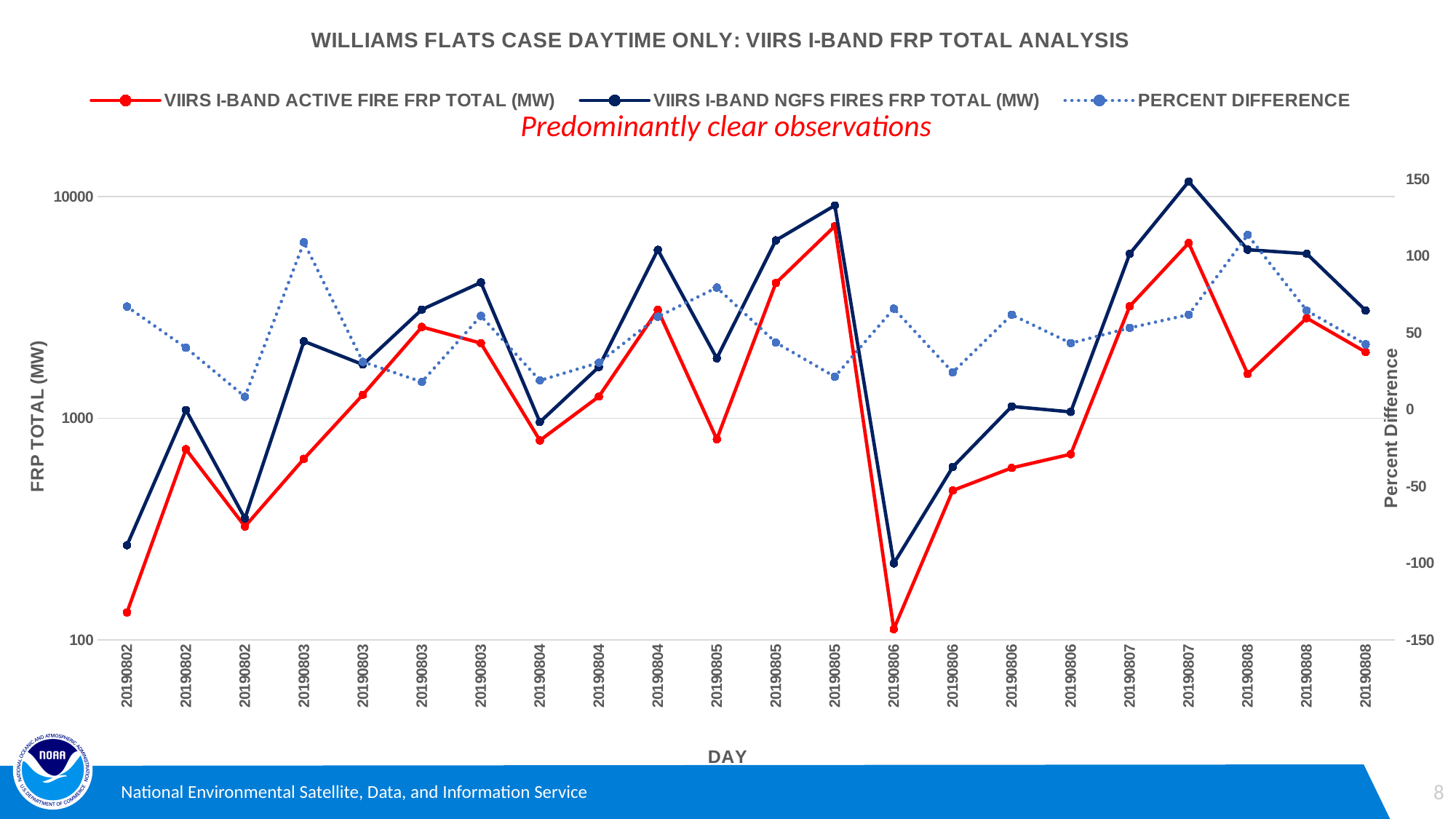
How many series does the legend list? 3 On which day does the PERCENT DIFFERENCE series reach its highest value? 20190808 How many data points are plotted along the x axis for each series? 22 What kind of chart is shown on the slide? line chart Is the highest value of the VIIRS I-BAND NGFS FIRES FRP TOTAL (MW) series greater or less than 10000? greater What is the label of the right-hand vertical axis? Percent Difference Between the first and second points on the x axis, does the VIIRS I-BAND ACTIVE FIRE FRP TOTAL (MW) series rise or fall? rise Is the lowest value of the VIIRS I-BAND ACTIVE FIRE FRP TOTAL (MW) series greater or less than 1000? less On which day does the VIIRS I-BAND ACTIVE FIRE FRP TOTAL (MW) series reach its lowest value? 20190806 What is the title of the chart? WILLIAMS FLATS CASE DAYTIME ONLY: VIIRS I-BAND FRP TOTAL ANALYSIS At the leftmost point (first 20190802), which series is higher: VIIRS I-BAND ACTIVE FIRE FRP TOTAL (MW) or VIIRS I-BAND NGFS FIRES FRP TOTAL (MW)? VIIRS I-BAND NGFS FIRES FRP TOTAL (MW) On which day does the VIIRS I-BAND NGFS FIRES FRP TOTAL (MW) series reach its highest value? 20190807